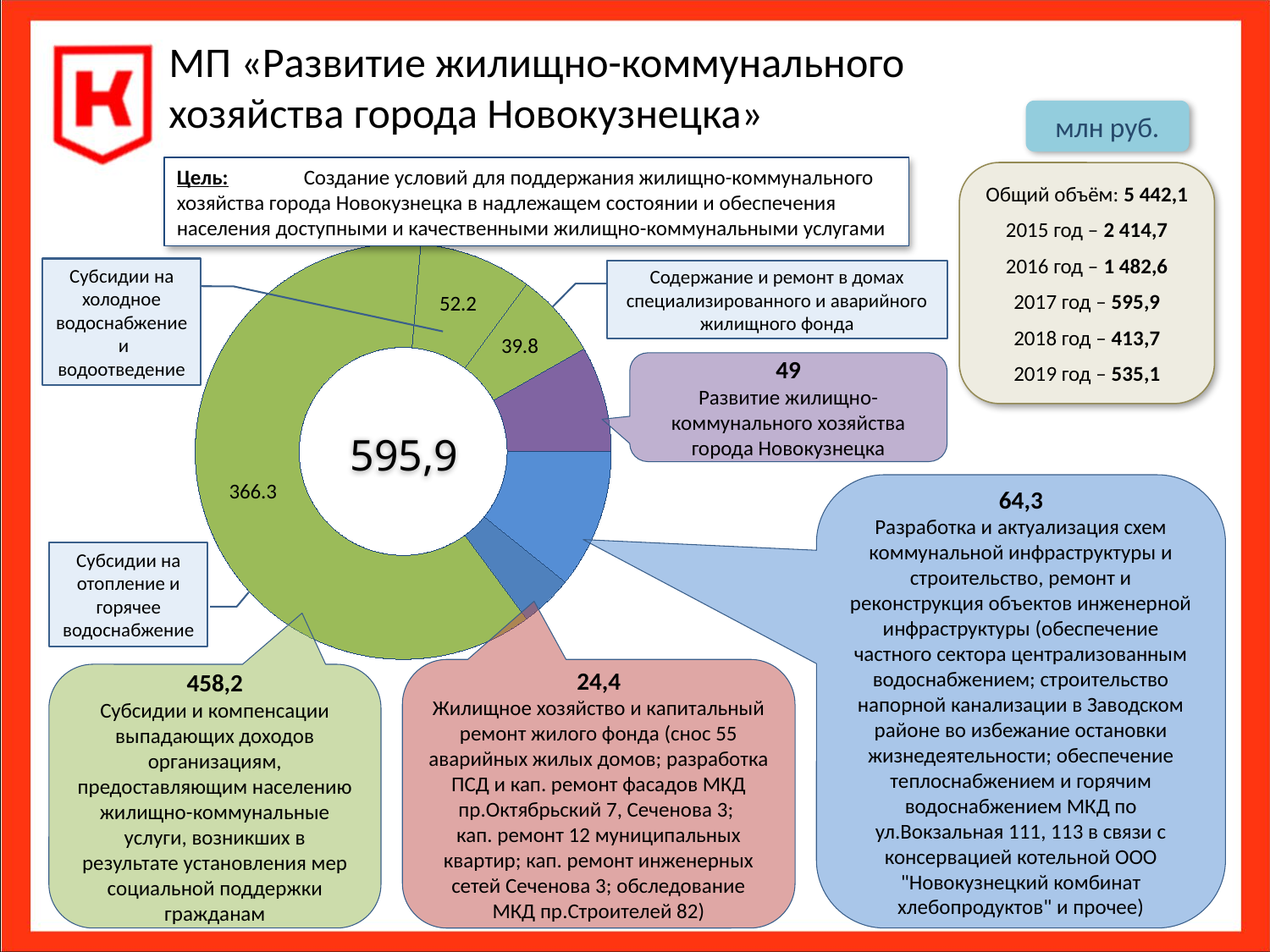
Which slice of the donut chart is the largest? Субсидии на отопление и горячее водоснабжение What value is given for «Развитие жилищно-коммунального хозяйства города Новокузнецка»? 49 What value is labelled on the slice for «Субсидии на отопление и горячее водоснабжение»? 366.3 What value is given for «Разработка и актуализация схем коммунальной инфраструктуры...»? 64,3 What is the difference between the slice labelled 52.2 and the slice labelled 39.8? 12.4 What is the difference between the value for «Разработка и актуализация схем...» (64,3) and the value for «Развитие жилищно-коммунального хозяйства города Новокузнецка» (49)? 15,3 What value is shown in the centre of the donut chart? 595,9 What value is given for «Жилищное хозяйство и капитальный ремонт жилого фонда»? 24,4 Which is larger: the slice for «Субсидии на холодное водоснабжение и водоотведение» or the slice for «Содержание и ремонт в домах специализированного и аварийного жилищного фонда»? Субсидии на холодное водоснабжение и водоотведение What type of chart is shown on the slide? Pie (donut) chart What value is labelled on the slice for «Содержание и ремонт в домах специализированного и аварийного жилищного фонда»? 39.8 What value is labelled on the slice for «Субсидии на холодное водоснабжение и водоотведение»? 52.2